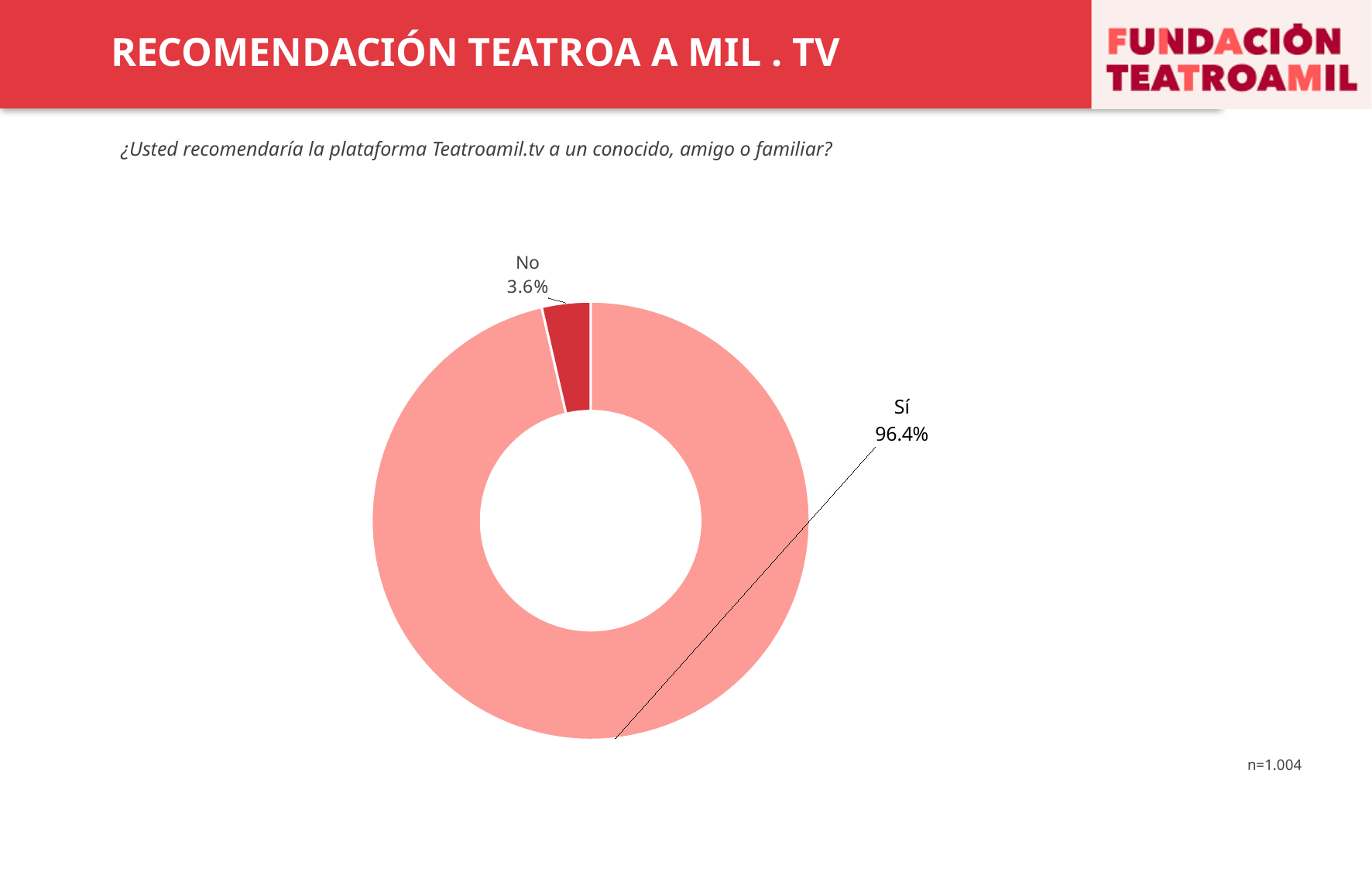
Which category has the largest share of the chart? Sí Which is larger, the share for "Sí" or the share for "No"? Sí What is the total of the two shares shown in the chart? 100% What percentage of respondents answered "No"? 3.6% What is the difference in percentage points between the "Sí" and "No" shares? 92.8 Which category has the smallest share of the chart? No What is the sample size (n) stated on the slide? n=1.004 What kind of chart is shown on the slide? Pie chart (donut) What percentage of respondents answered "Sí"? 96.4% How many categories are shown in the chart? 2 What colour is the "No" slice of the chart? Dark red